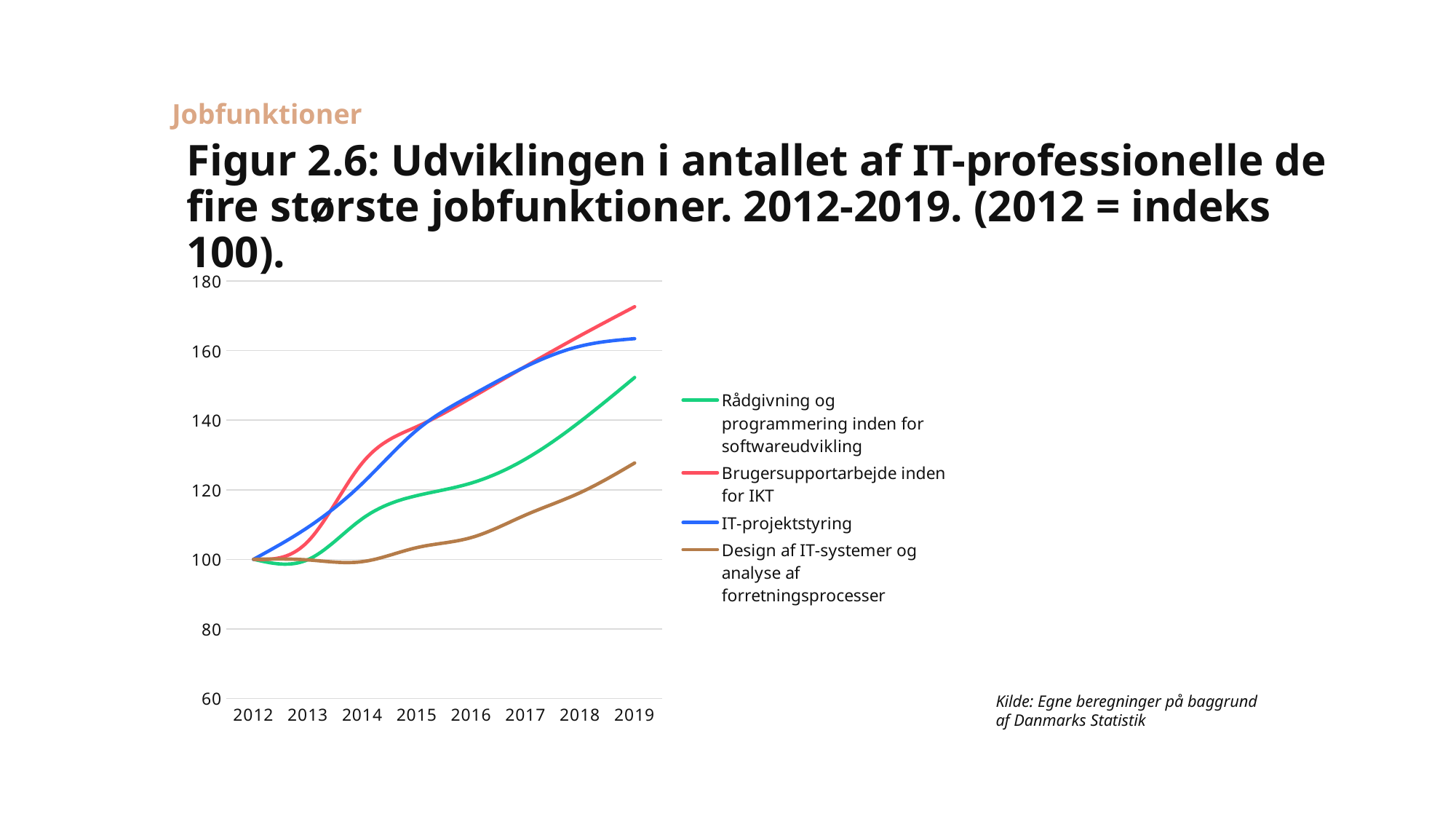
Is the value for Rådgivning og programmering inden for softwareudvikling in 2019 greater or less than 140? greater What is the index value for IT-projektstyring in 2012? 100 Which series has the highest value in 2019? Brugersupportarbejde inden for IKT How many years are shown on the x axis? 8 Is the value for Brugersupportarbejde inden for IKT in 2019 greater or less than 160? greater What kind of chart is shown on the slide? Line chart Which series has the lowest value in 2019? Design af IT-systemer og analyse af forretningsprocesser In 2019, which is larger: Rådgivning og programmering inden for softwareudvikling or Design af IT-systemer og analyse af forretningsprocesser? Rådgivning og programmering inden for softwareudvikling Does the IT-projektstyring series rise or fall from 2012 to 2019? Rise How many series does the legend list? 4 Is the value for Design af IT-systemer og analyse af forretningsprocesser in 2019 greater or less than 140? less What colour is the line for Brugersupportarbejde inden for IKT? Red